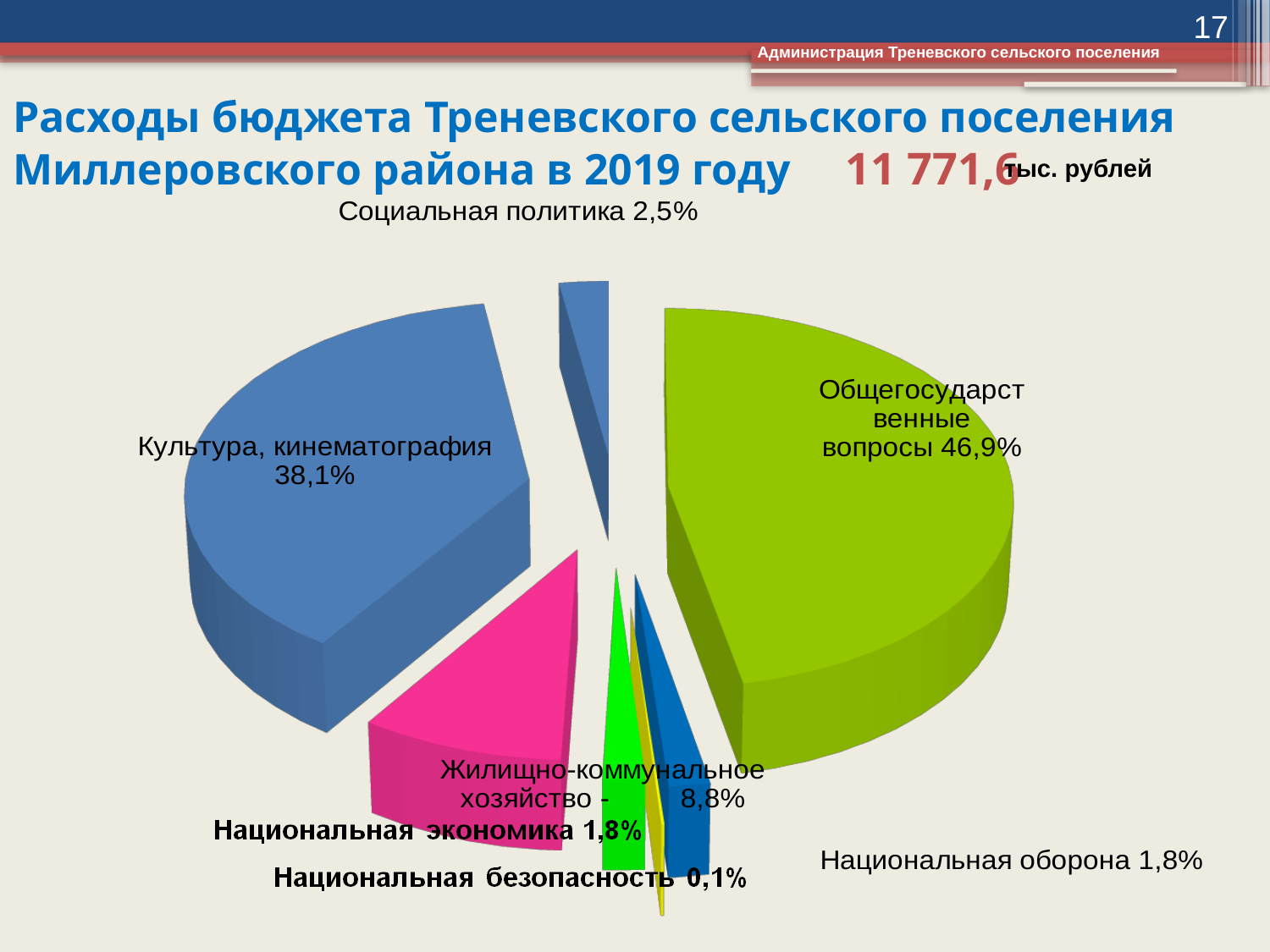
What share of the budget expenditures goes to Социальная политика? 2,5% What share of the budget expenditures goes to Жилищно-коммунальное хозяйство? 8,8% What share of the budget expenditures goes to Общегосударственные вопросы? 46,9% What share of the budget expenditures goes to Культура, кинематография? 38,1% What share of the budget expenditures goes to Национальная безопасность? 0,1% What kind of chart is shown on the slide? pie chart Which category has the largest share of the budget expenditures? Общегосударственные вопросы Which category has the smallest share of the budget expenditures? Национальная безопасность What is the difference in percentage points between the shares of Общегосударственные вопросы and Культура, кинематография? 8,8 Which has a larger share: Жилищно-коммунальное хозяйство or Социальная политика? Жилищно-коммунальное хозяйство How many categories are shown in the pie chart? 7 What is the total amount of budget expenditures shown on the slide, in thousand rubles? 11 771,6